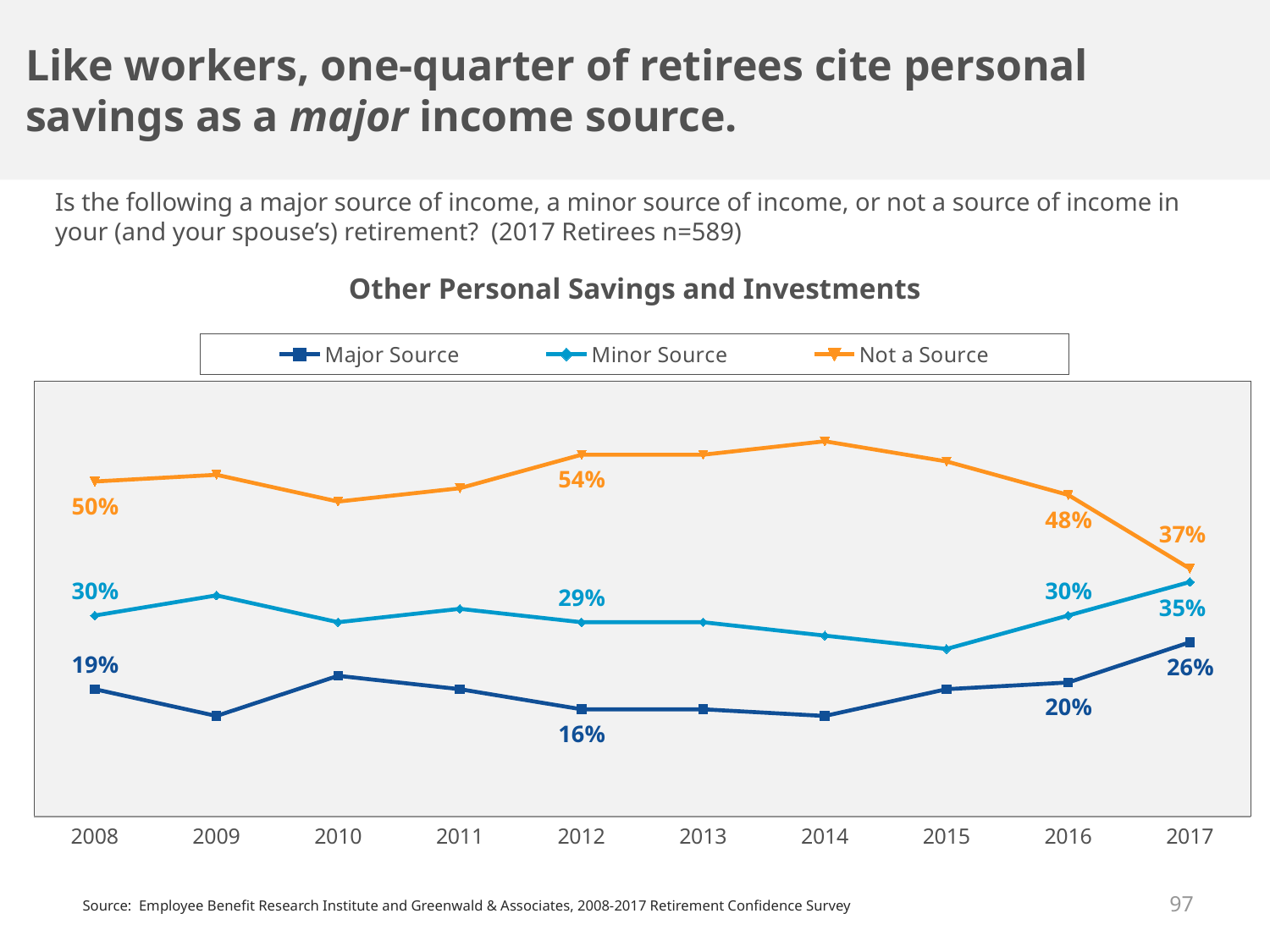
What type of chart is shown on the slide? line chart What is the value for Major Source in 2017? 26% Which is larger in 2017, Not a Source or Minor Source? Not a Source What is the difference between the Not a Source values in 2016 and 2017? 11 percentage points What is the value for Major Source in 2008? 19% What is the title of the chart? Other Personal Savings and Investments How many years are shown on the x axis? 10 What is the value for Minor Source in 2016? 30% What is the value for Not a Source in 2012? 54% Among the labeled years, in which year is the Major Source value lowest? 2012 Does the Not a Source line rise or fall from 2014 to 2017? fall How many series does the legend list? 3